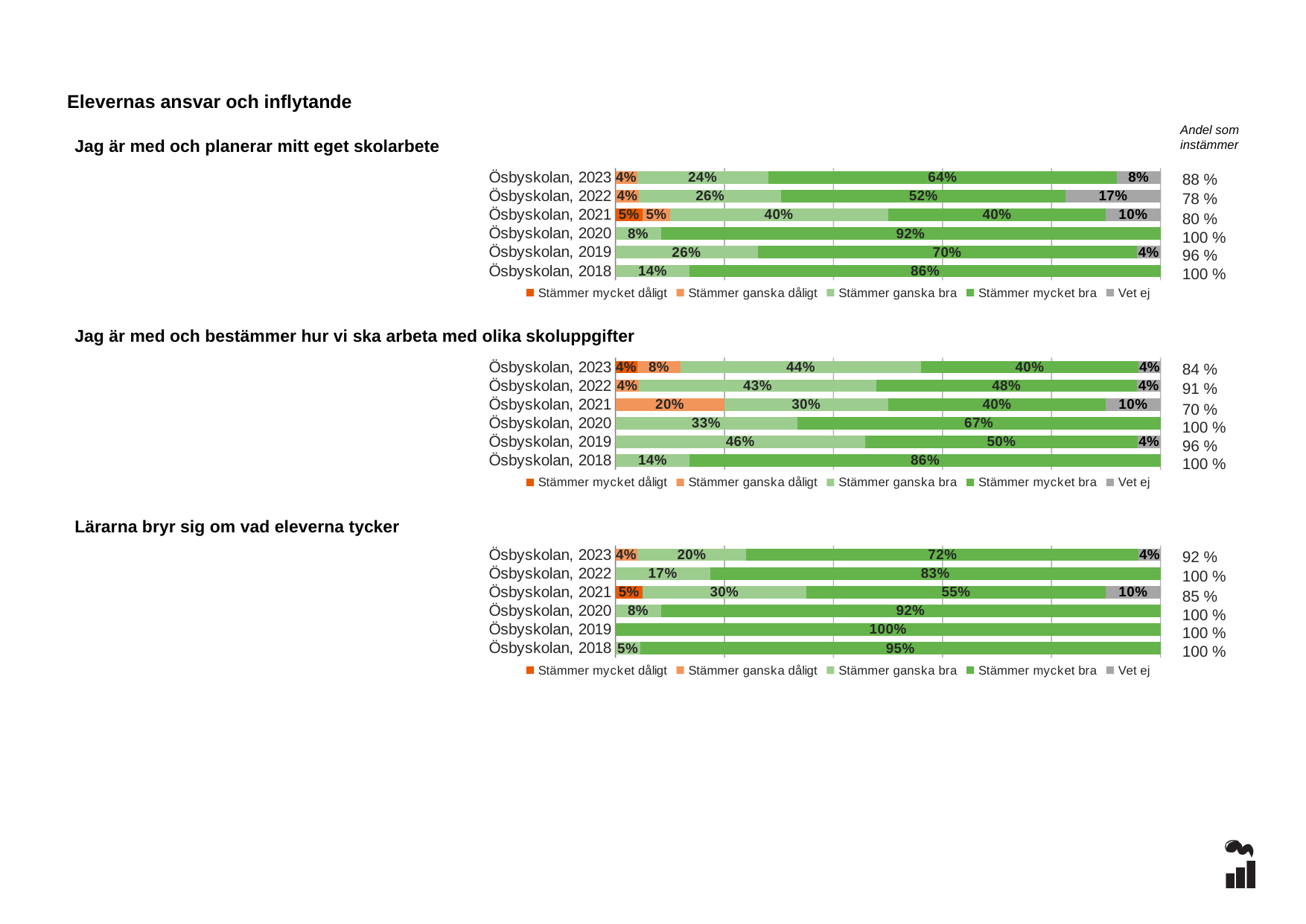
In the chart "Lärarna bryr sig om vad eleverna tycker", what is the "Stämmer mycket bra" value for Ösbyskolan, 2019? 100% In the chart "Jag är med och planerar mitt eget skolarbete", which year has the lowest "Andel som instämmer"? Ösbyskolan, 2022 In the chart "Jag är med och bestämmer hur vi ska arbeta med olika skoluppgifter", what is the "Stämmer ganska dåligt" value for Ösbyskolan, 2021? 20% In the chart "Jag är med och planerar mitt eget skolarbete", what is the "Vet ej" value for Ösbyskolan, 2022? 17% How many bars (years) are shown in the chart "Lärarna bryr sig om vad eleverna tycker"? 6 In the chart "Jag är med och bestämmer hur vi ska arbeta med olika skoluppgifter", what is the difference between the "Stämmer mycket bra" values for Ösbyskolan, 2022 and Ösbyskolan, 2023? 8% In the chart "Jag är med och bestämmer hur vi ska arbeta med olika skoluppgifter", which is larger: the "Stämmer ganska bra" value for Ösbyskolan, 2019 or for Ösbyskolan, 2020? Ösbyskolan, 2019 In the chart "Lärarna bryr sig om vad eleverna tycker", what is the "Andel som instämmer" for Ösbyskolan, 2021? 85 % How many series does the legend of the chart "Jag är med och planerar mitt eget skolarbete" list? 5 In the chart "Lärarna bryr sig om vad eleverna tycker", which year has the highest "Stämmer ganska bra" value? Ösbyskolan, 2021 What kind of chart is used for "Jag är med och bestämmer hur vi ska arbeta med olika skoluppgifter"? Stacked bar chart In the chart "Jag är med och planerar mitt eget skolarbete", what is the "Stämmer mycket bra" value for Ösbyskolan, 2023? 64%